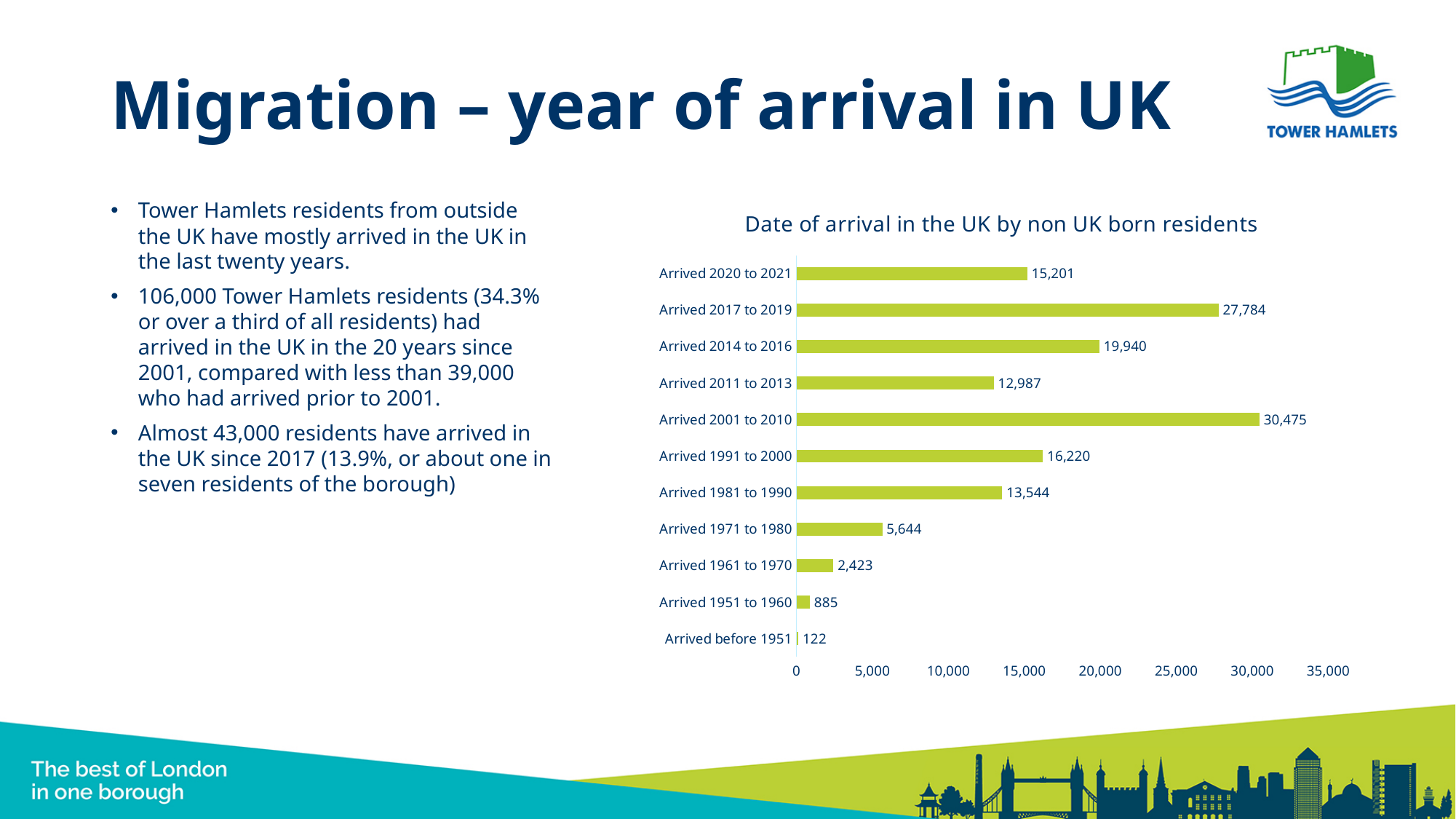
Which is larger, the value for 'Arrived 1991 to 2000' or 'Arrived 1981 to 1990'? Arrived 1991 to 2000 Which arrival period has the highest value? Arrived 2001 to 2010 What kind of chart is shown on the slide? bar chart What is the value for 'Arrived 2001 to 2010'? 30,475 Which arrival period has the lowest value? Arrived before 1951 What is the value for 'Arrived 2017 to 2019'? 27,784 What is the difference between the values for 'Arrived 2017 to 2019' and 'Arrived 2020 to 2021'? 12,583 What is the value for 'Arrived 1961 to 1970'? 2,423 How many arrival periods are shown in the chart? 11 What is the highest value shown on the horizontal axis? 35,000 What is the title of the chart? Date of arrival in the UK by non UK born residents Is the value for 'Arrived 2014 to 2016' greater or less than 15,000? greater